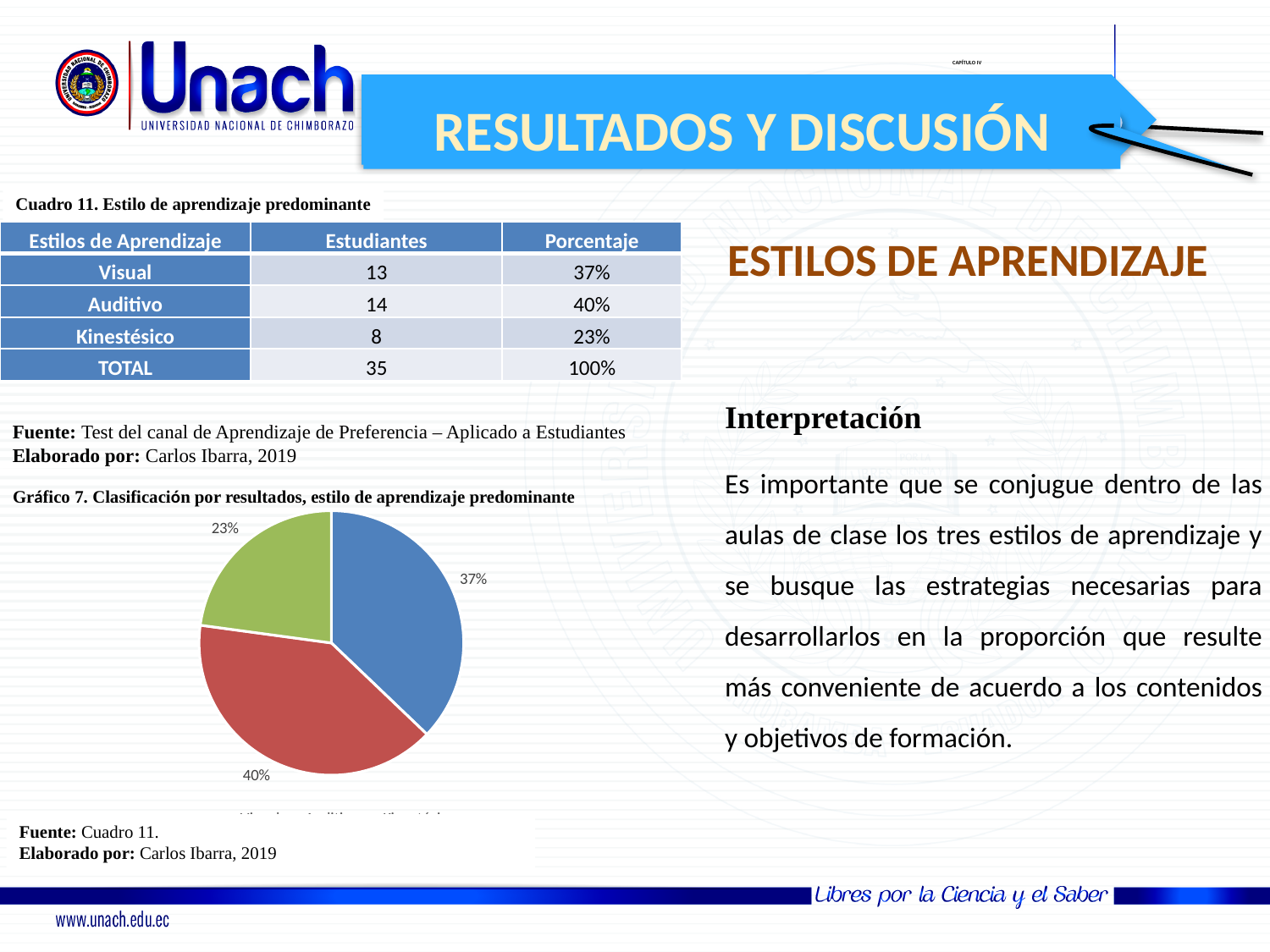
According to the table Cuadro 11 that the pie chart is based on, which learning style corresponds to the 40% slice? Auditivo In the pie chart, what percentage is shown for the blue slice? 37% What is the difference in percentage points between the red slice and the blue slice of the pie chart? 3 percentage points In the pie chart, what percentage is shown for the green slice? 23% In the pie chart, what percentage is shown for the red slice? 40% In the pie chart, which is larger: the blue slice or the green slice? the blue slice What is the difference in percentage points between the red slice and the green slice of the pie chart? 17 percentage points What kind of chart is Gráfico 7 on the slide? pie chart How many slices does the pie chart in Gráfico 7 have? 3 Which slice of the pie chart has the smallest share? the green slice (23%) What is the title of the pie chart on the slide? Gráfico 7. Clasificación por resultados, estilo de aprendizaje predominante Which slice of the pie chart has the largest share? the red slice (40%)